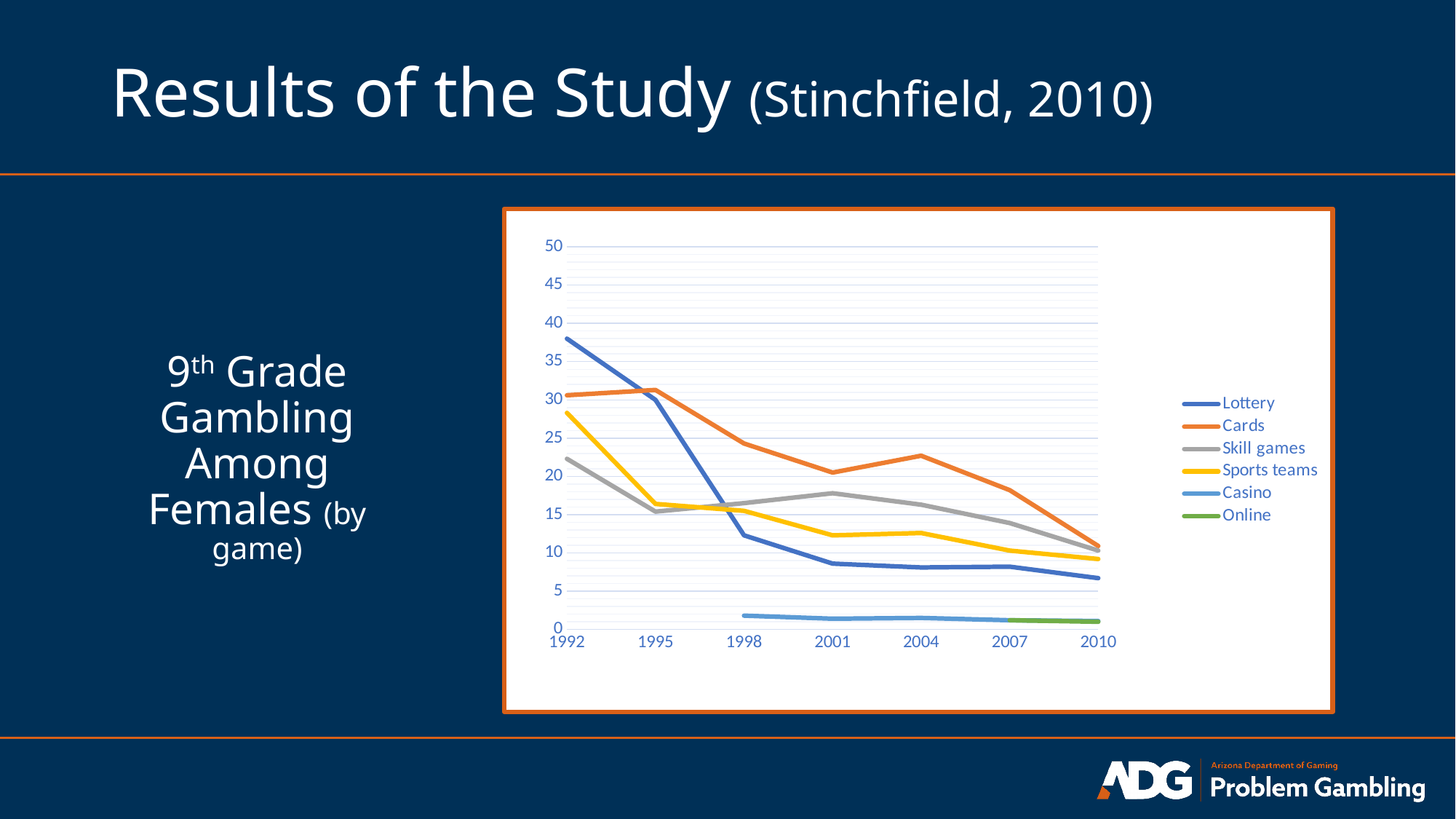
How many series does the legend list? 6 Is the value for Lottery in 2010 greater or less than 10? less Is the value for Sports teams in 1992 greater or less than 25? greater Is the value for Cards in 2004 greater or less than 20? greater Which series has the highest value in 1992? Lottery In 1998, which is larger, the value for Cards or the value for Lottery? Cards Which series has the highest value in 2004? Cards What kind of chart is shown on the slide? line chart Does the Lottery line rise or fall from 1992 to 2010? fall How many years are shown on the x axis? 7 Which series first appears in 2007 on the chart? Online